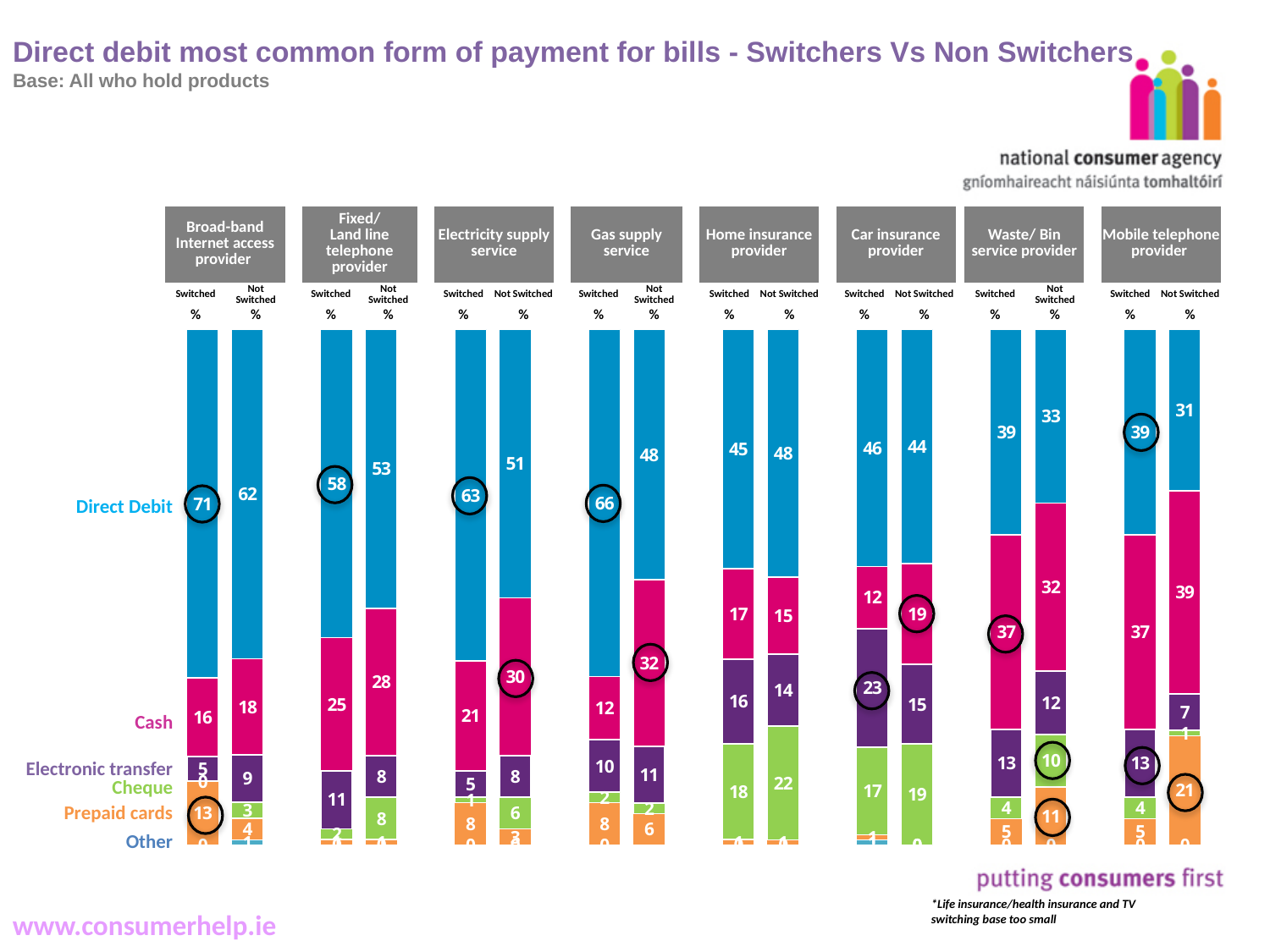
Which product and group has the lowest Direct Debit percentage on the chart? Mobile telephone provider, Not Switched Which product has the highest Direct Debit percentage among customers who switched? Broad-band Internet access provider For Electricity supply service, which group has a higher Cash percentage, Switched or Not Switched? Not Switched What percentage of Mobile telephone provider customers who did not switch pay by Prepaid cards? 21% What percentage of Broad-band Internet access provider customers who switched pay by Direct Debit? 71% What percentage of Gas supply service customers who did not switch pay by Cash? 32% How many payment methods are listed as segments on the chart? 6 How many product categories are shown on the chart? 8 For Home insurance provider, which group has a higher Cheque percentage, Switched or Not Switched? Not Switched What is the difference in Direct Debit percentage between Switched and Not Switched customers for Gas supply service? 18 What type of chart is shown on the slide? Stacked bar chart What percentage of Car insurance provider customers who switched pay by Electronic transfer? 23%